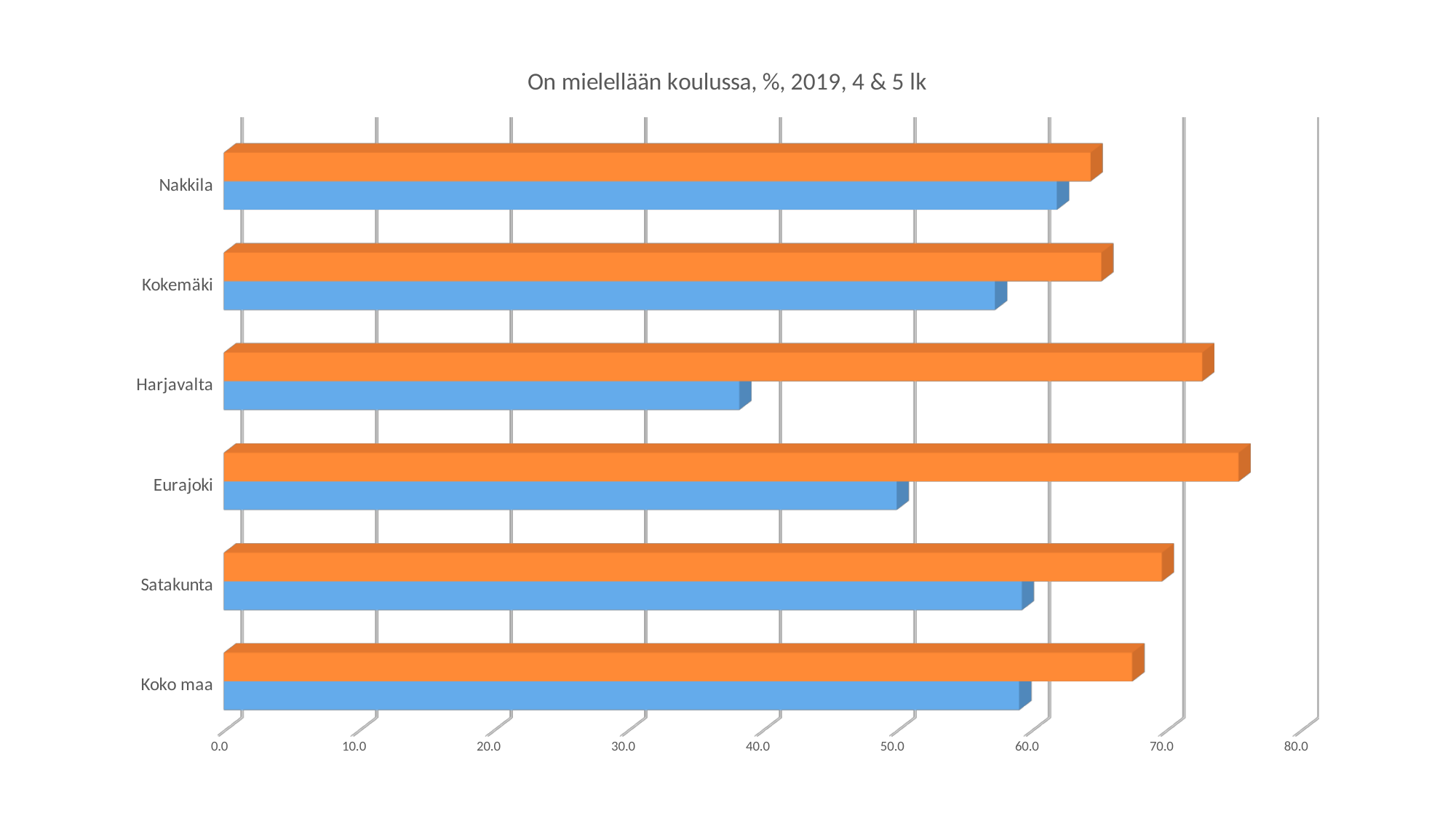
Which category has the longest orange bar? Eurajoki Is the blue bar for Harjavalta greater or less than 40.0? less Which is longer, the blue bar for Eurajoki or the blue bar for Nakkila? Nakkila What is the title of the chart? On mielellään koulussa, %, 2019, 4 & 5 lk What kind of chart is shown on the slide? bar chart How many data series are plotted for each category? 2 How many categories are shown on the chart? 6 Is the blue bar for Kokemäki greater or less than 60.0? less Is the orange bar for Koko maa greater or less than 70.0? less For Harjavalta, which bar is longer, the orange one or the blue one? orange Which category has the shortest blue bar? Harjavalta